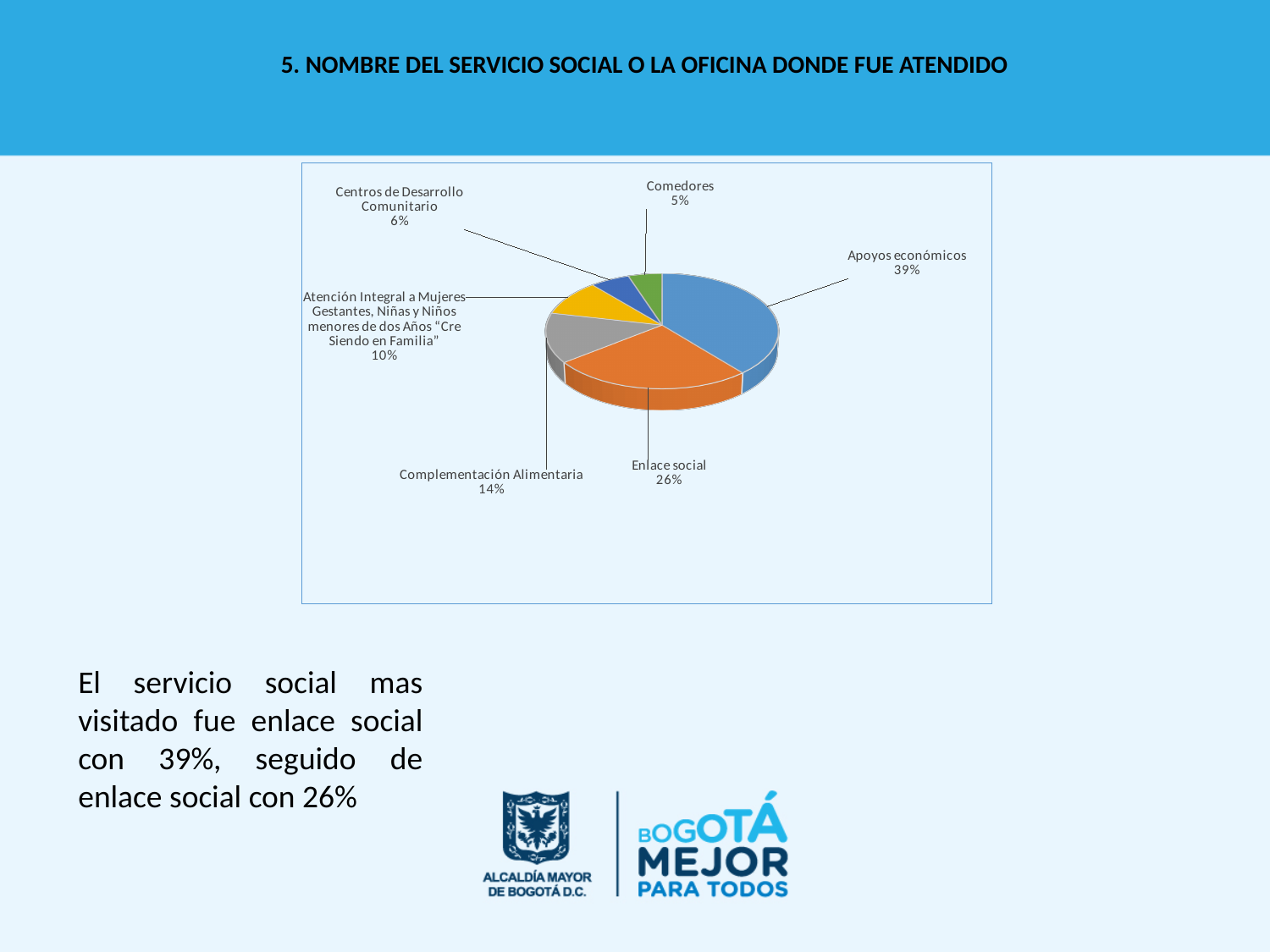
What kind of chart is shown on the slide? Pie chart What colour is the slice for Apoyos económicos? Blue What is the difference in percentage points between Apoyos económicos and Enlace social? 13 What share of the pie does Centros de Desarrollo Comunitario represent? 6% Which category has the largest share of the pie? Apoyos económicos What share of the pie does Apoyos económicos represent? 39% What share of the pie does Complementación Alimentaria represent? 14% Which is larger, the share for Complementación Alimentaria or the share for Centros de Desarrollo Comunitario? Complementación Alimentaria Which category has the smallest share of the pie? Comedores How many categories are shown in the pie chart? 6